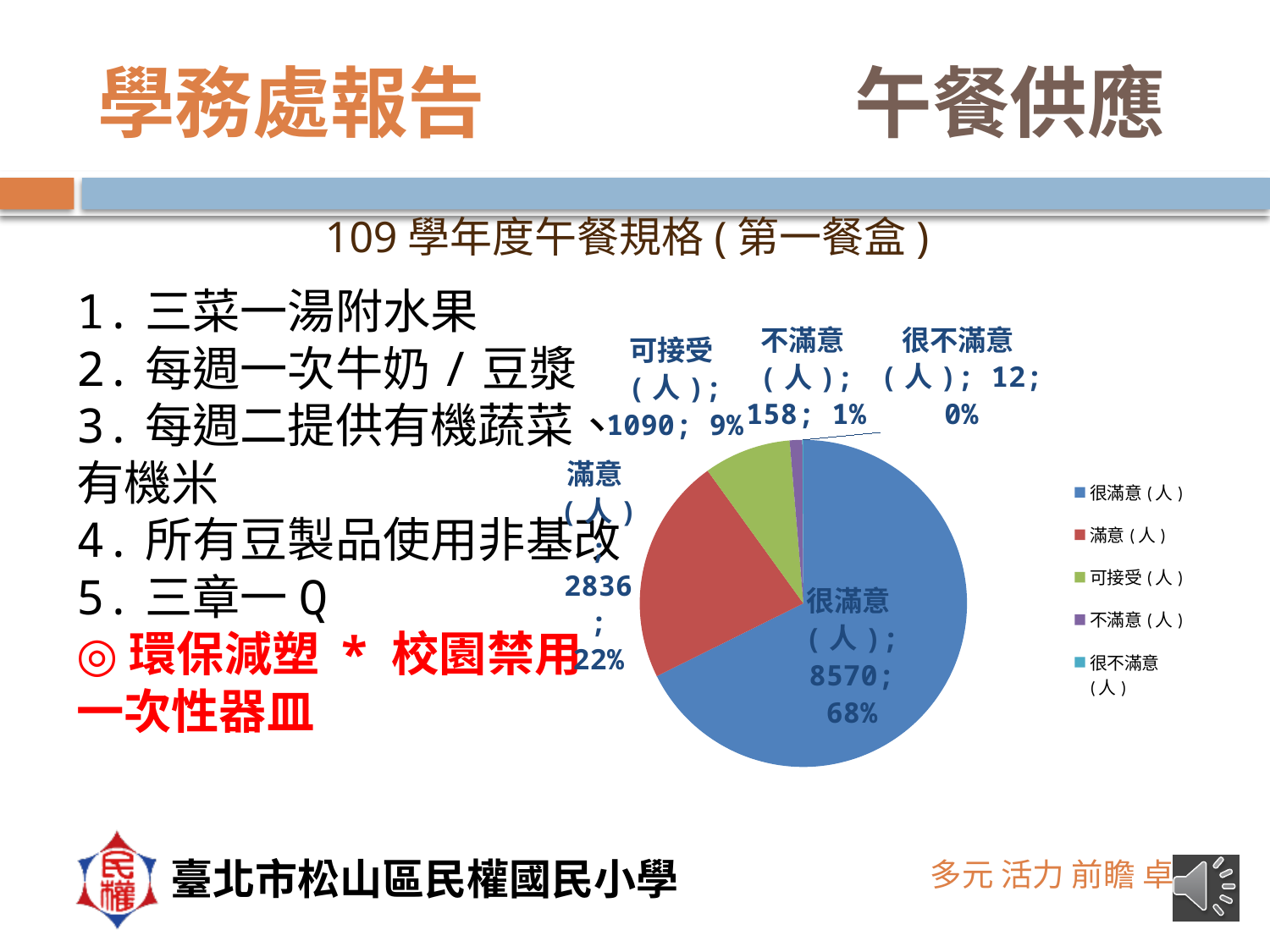
What is the number of people for 不滿意 (人) in the pie chart? 158 How many categories does the pie chart's legend list? 5 What percentage share does 很滿意 (人) have in the pie chart? 68% What is the number of people for 很不滿意 (人) in the pie chart? 12 What percentage share does 可接受 (人) have in the pie chart? 9% What is the difference in number of people between 很滿意 (人) and 滿意 (人)? 5734 Which is larger in the pie chart, 可接受 (人) or 不滿意 (人)? 可接受 (人) What kind of chart is shown on the slide? pie chart What is the number of people for 很滿意 (人) in the pie chart? 8570 Which category has the smallest slice in the pie chart? 很不滿意 (人) What is the number of people for 滿意 (人) in the pie chart? 2836 Which category has the largest slice in the pie chart? 很滿意 (人)